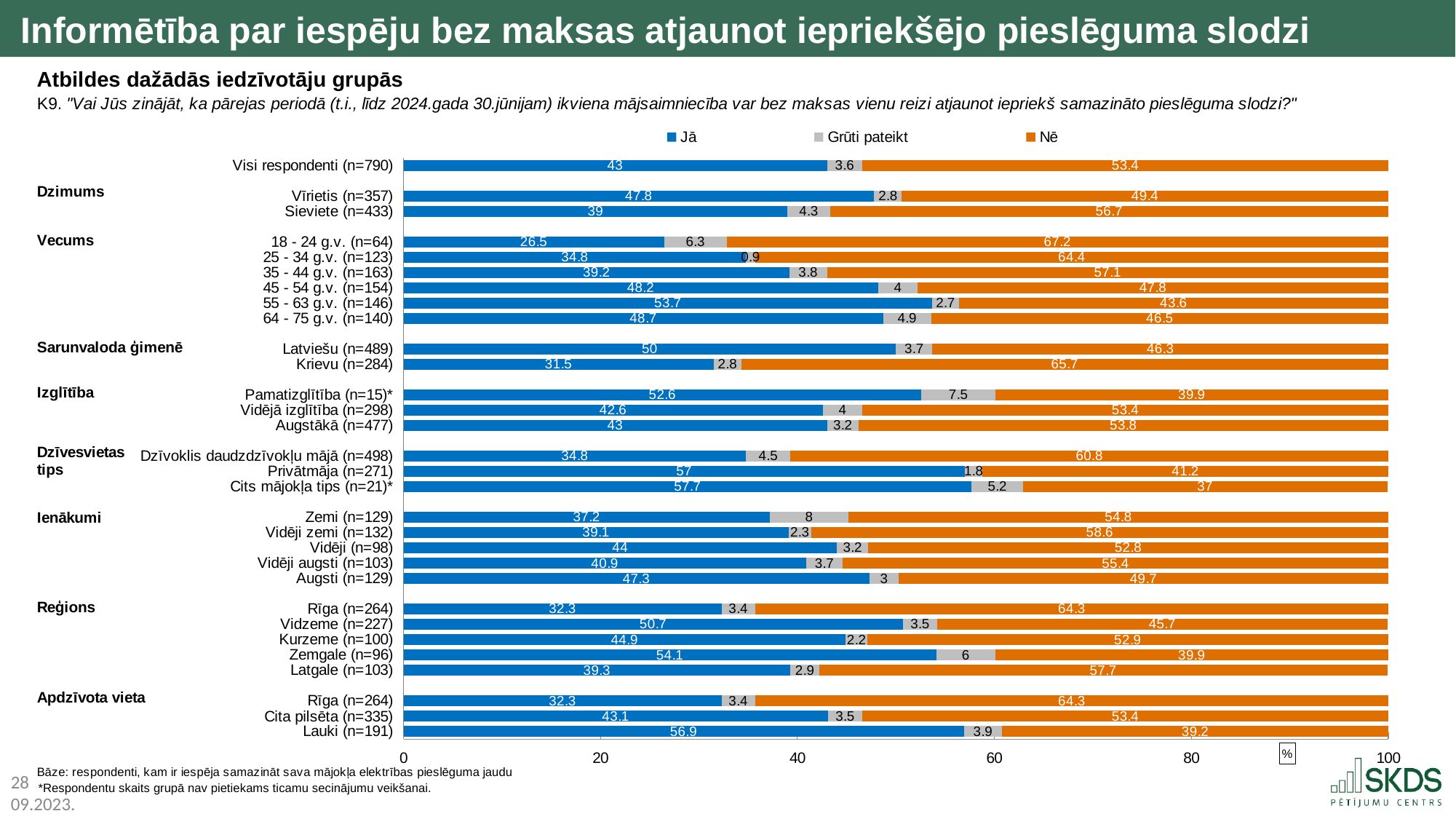
What kind of chart is shown on the slide? Stacked bar chart Among the Vecums (age) groups, which has the highest "Jā" value? 55 - 63 g.v. (n=146) Which colour represents "Nē" in the legend? Orange What percentage of all respondents (Visi respondenti, n=790) answered "Jā"? 43 How many categories are shown under Reģions? 5 Which has a larger "Jā" value: Privātmāja (n=271) or Dzīvoklis daudzdzīvokļu mājā (n=498)? Privātmāja (n=271) How many series does the legend list? 3 Among the Reģions groups, which has the highest "Nē" value? Rīga (n=264) Which group on the chart has the lowest "Jā" value? 18 - 24 g.v. (n=64) What is the "Nē" value for Krievu (n=284)? 65.7 What is the "Grūti pateikt" value for Zemi (n=129)? 8 What is the difference between the "Jā" values for Vīrietis (n=357) and Sieviete (n=433)? 8.8